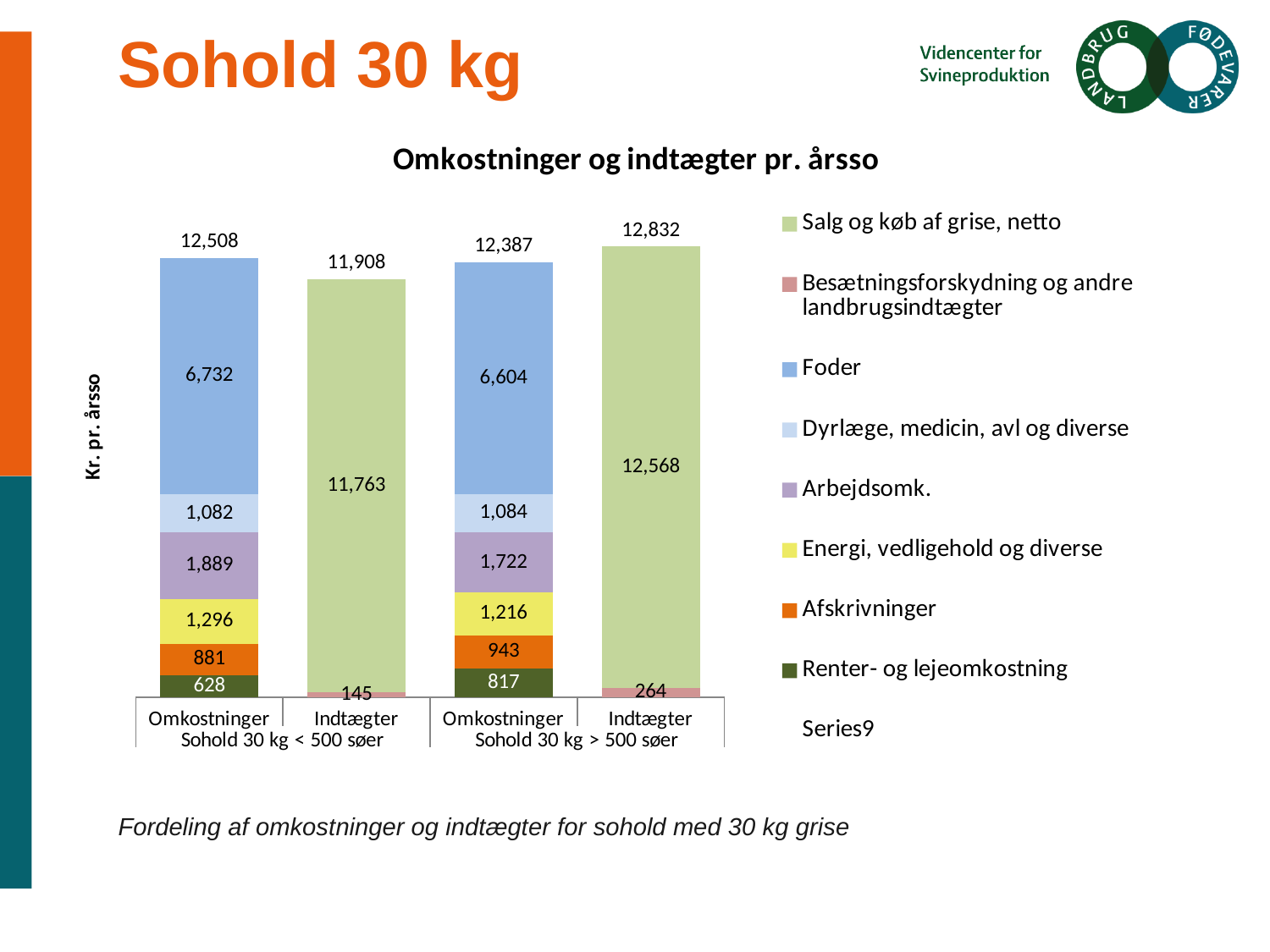
What is the difference between the total Indtægter and total Omkostninger for Sohold 30 kg > 500 søer? 445 What is the Foder value for Omkostninger in the Sohold 30 kg < 500 søer group? 6,732 Which is larger: the Renter- og lejeomkostning value for Omkostninger in the < 500 søer group or in the > 500 søer group? > 500 søer (817) How many entries does the legend list? 9 How many bars are shown in the chart? 4 Which bar has the lowest total value? Indtægter, Sohold 30 kg < 500 søer Which bar has the highest total value? Indtægter, Sohold 30 kg > 500 søer What is the Salg og køb af grise, netto value for Indtægter in the Sohold 30 kg > 500 søer group? 12,568 What type of chart is shown on the slide? Stacked bar chart What is the Arbejdsomk. value for Omkostninger in the Sohold 30 kg > 500 søer group? 1,722 What is the difference between the Foder values for Omkostninger in the < 500 søer and > 500 søer groups? 128 What is the total shown above the Indtægter bar for Sohold 30 kg < 500 søer? 11,908